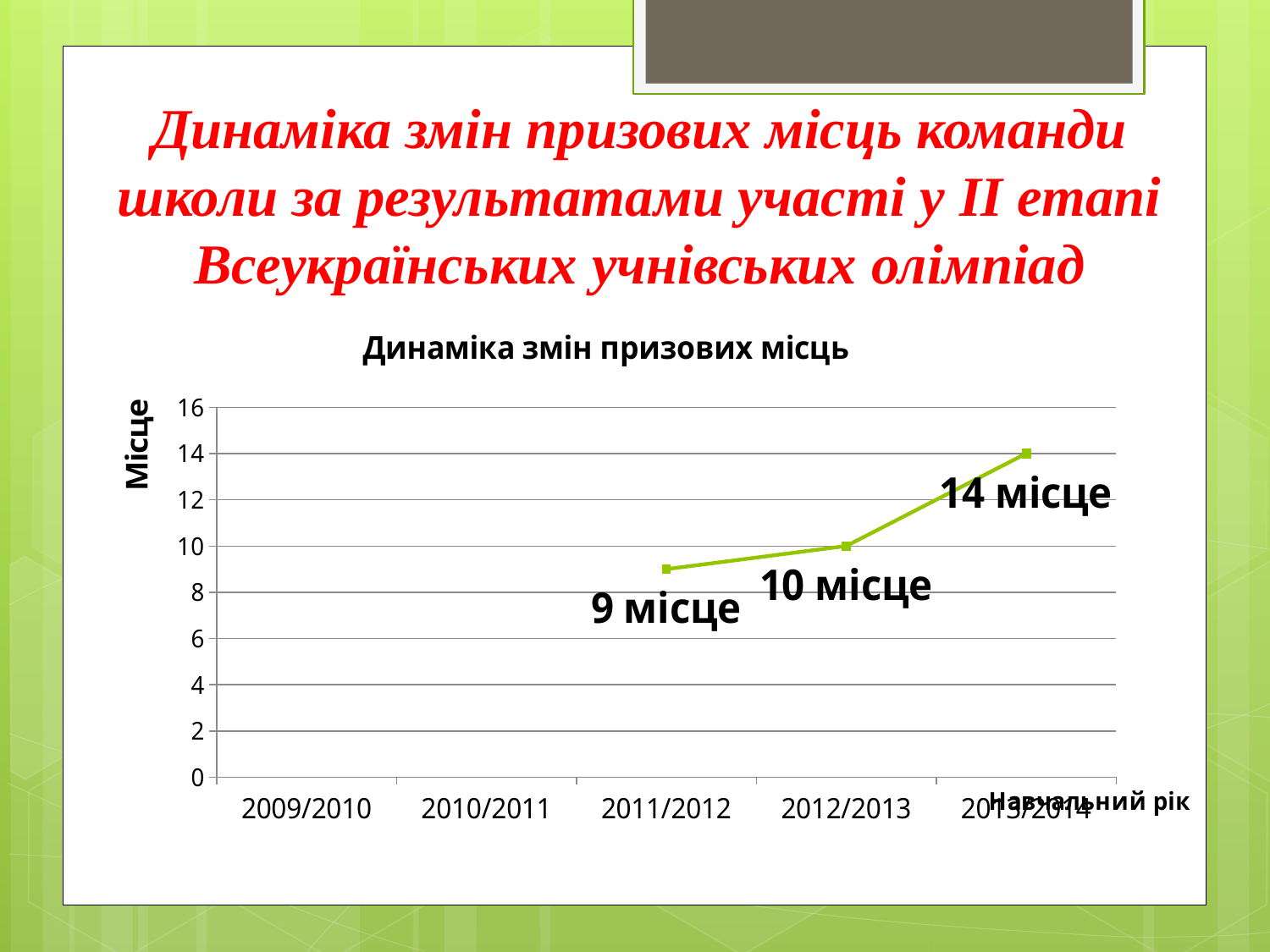
What value is shown for 2011/2012? 9 місце How many years are labelled on the x axis? 5 Is the value for 2013/2014 greater or less than 12? greater How many data points are plotted on the line? 3 Which year has the lowest plotted value? 2011/2012 What kind of chart is this? line chart What value is shown for 2012/2013? 10 місце Do the plotted values rise or fall from 2011/2012 to 2013/2014? rise Which year has the highest plotted value? 2013/2014 What is the difference between the values for 2013/2014 and 2012/2013? 4 What value is shown for 2013/2014? 14 місце Which is larger, the value for 2012/2013 or the value for 2011/2012? 2012/2013